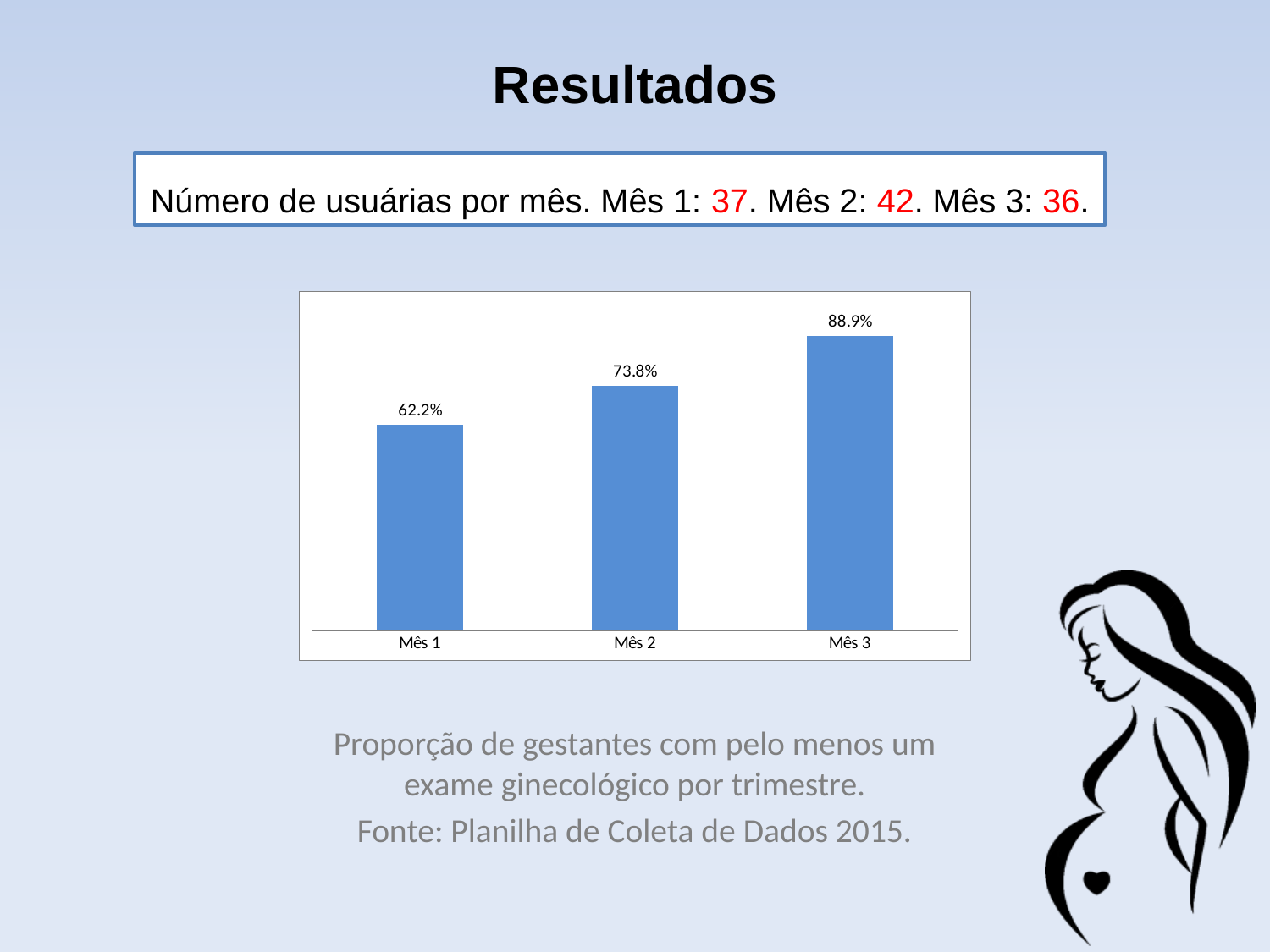
What kind of chart is shown on the slide? Bar chart Which month has the highest value? Mês 3 Which month has the lowest value? Mês 1 How many categories are shown in the chart? 3 What is the value for Mês 1? 62.2% What is the value for Mês 2? 73.8% Which is larger, the value for Mês 2 or the value for Mês 3? Mês 3 What is the value for Mês 3? 88.9% What is the difference between the values for Mês 3 and Mês 1? 26.7% According to the caption below the chart, what does the chart show? Proporção de gestantes com pelo menos um exame ginecológico por trimestre What is the difference between the values for Mês 2 and Mês 1? 11.6% Do the values rise or fall from Mês 1 to Mês 3? Rise